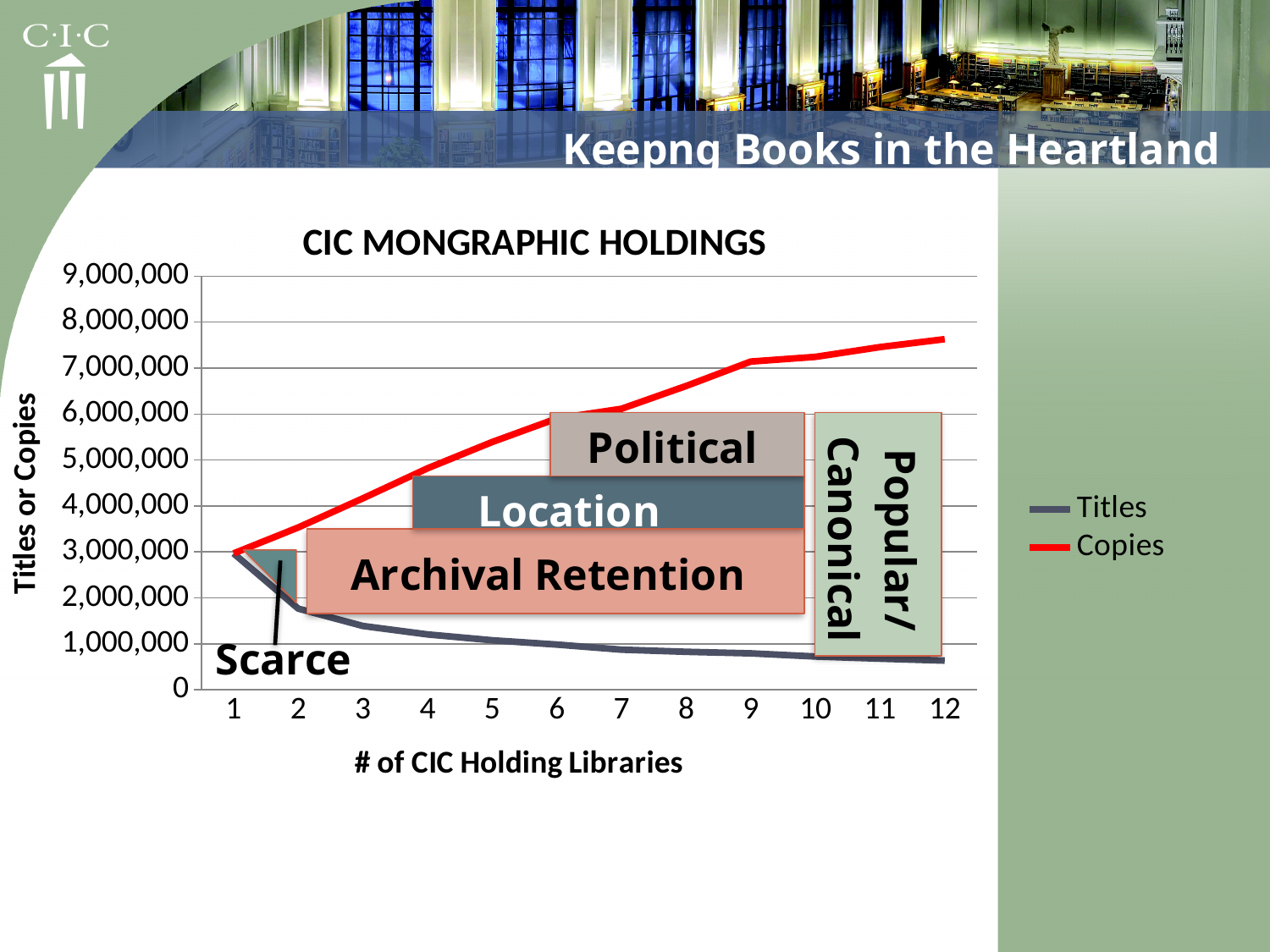
Is the value of Copies at 12 holding libraries greater or less than 7,000,000? greater Does the Copies line rise or fall as the number of CIC holding libraries increases from 1 to 12? Rises How many points along the x axis (# of CIC Holding Libraries) does the chart plot? 12 What is the label of the y axis of the chart? Titles or Copies Is the value of Titles at 12 holding libraries greater or less than 1,000,000? less What kind of chart is shown under the title "CIC MONGRAPHIC HOLDINGS"? Line chart How many series does the legend of the CIC MONGRAPHIC HOLDINGS chart list? 2 At which number of CIC holding libraries does the Copies line reach its highest value? 12 Does the Titles line rise or fall as the number of CIC holding libraries increases from 1 to 12? Falls Is the value of Titles at 2 holding libraries greater or less than 2,000,000? less At 12 holding libraries, which series has the larger value, Titles or Copies? Copies